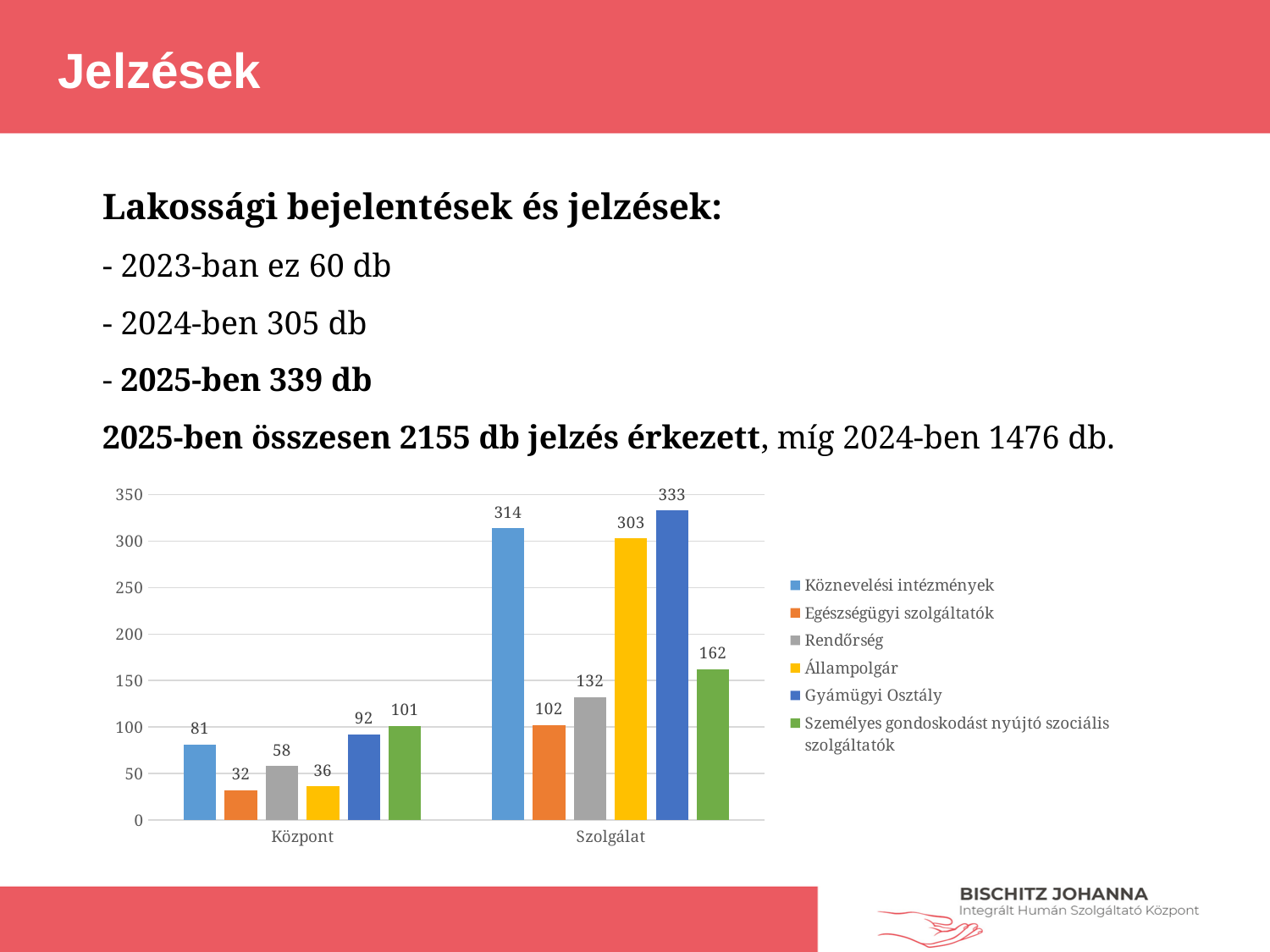
Which series has the highest value in the Szolgálat category? Gyámügyi Osztály What colour represents Állampolgár in the chart? Yellow What is the difference between the Szolgálat and Központ values for Egészségügyi szolgáltatók? 70 How many categories are shown on the x axis? 2 Which series has the lowest value in the Központ category? Egészségügyi szolgáltatók What kind of chart is shown on the slide? Bar chart Which is larger in the Központ category: Gyámügyi Osztály or Személyes gondoskodást nyújtó szociális szolgáltatók? Személyes gondoskodást nyújtó szociális szolgáltatók What is the value for Köznevelési intézmények in the Központ category? 81 What is the value for Állampolgár in the Szolgálat category? 303 How many series does the legend list? 6 What is the value for Rendőrség in the Központ category? 58 What is the value for Gyámügyi Osztály in the Szolgálat category? 333